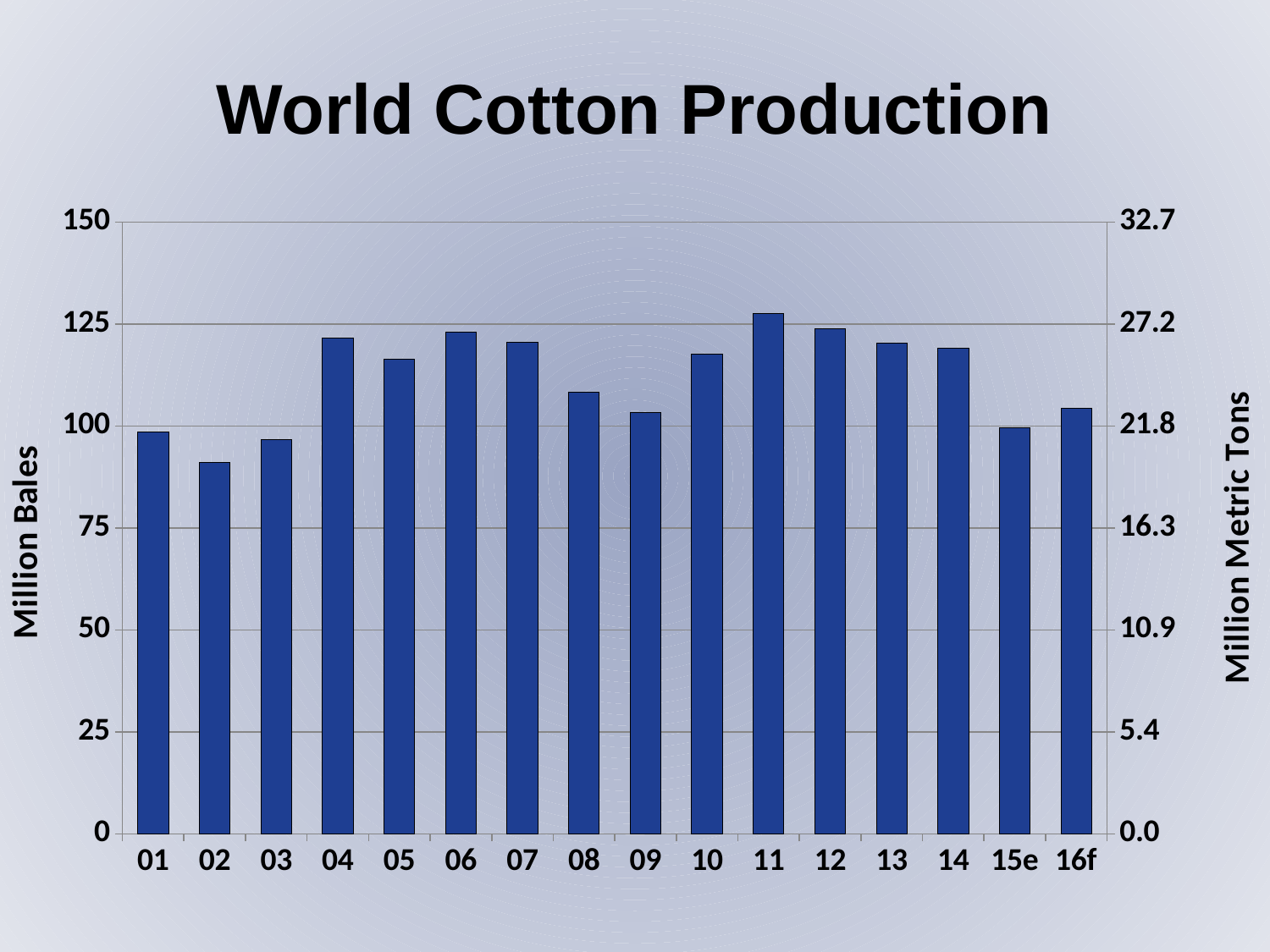
Is the value for 11 greater or less than 125 million bales? greater What kind of chart is shown on the slide? bar chart Which year has the larger value, 04 or 01? 04 Is the value for 02 greater or less than 100 million bales? less Which year has the highest world cotton production? 11 Which year has the larger value, 06 or 05? 06 What is the label of the right-hand vertical axis? Million Metric Tons Is the value for 08 greater or less than 100 million bales? greater What is the title of the chart? World Cotton Production Which year has the lowest world cotton production? 02 How many years (categories) are shown on the x axis? 16